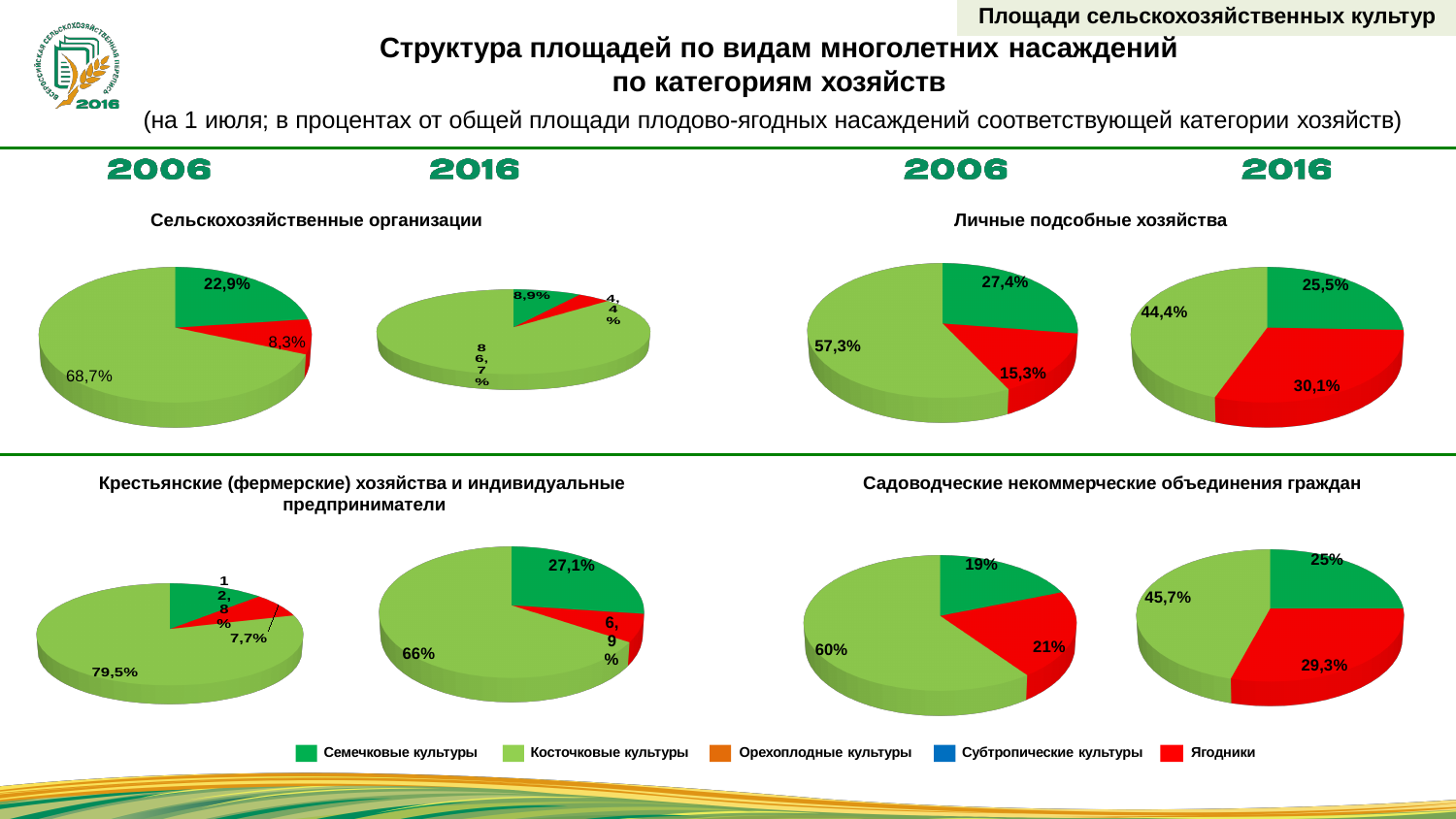
In the 2006 pie chart for Личные подсобные хозяйства, what is the value of the dark green slice (Семечковые культуры)? 27,4% In the 2006 pie chart for Сельскохозяйственные организации, what share is labelled on the largest slice? 68,7% What type of chart is used on this slide? pie chart In the 2016 pie chart for Личные подсобные хозяйства, which is larger: the red slice (30,1%) or the dark green slice (25,5%)? the red slice (30,1%) In the 2006 pie chart for Садоводческие некоммерческие объединения граждан, what is the difference between the red slice (21%) and the dark green slice (19%)? 2% In the 2016 pie chart for Садоводческие некоммерческие объединения граждан, which slice is the smallest? 25% (dark green, Семечковые культуры) How many pie charts are shown on the slide? 8 In the 2006 pie chart for Крестьянские (фермерские) хозяйства и индивидуальные предприниматели, what is the value of the red slice (Ягодники)? 7,7% In the 2016 pie chart for Личные подсобные хозяйства, which slice is the largest? 44,4% (light green, Косточковые культуры) In the 2016 pie chart for Сельскохозяйственные организации, what is the value of the red slice (Ягодники)? 4,4% How many categories does the legend at the bottom of the slide list? 5 In the 2016 pie chart for Крестьянские (фермерские) хозяйства и индивидуальные предприниматели, what is the value of the light green slice? 66%